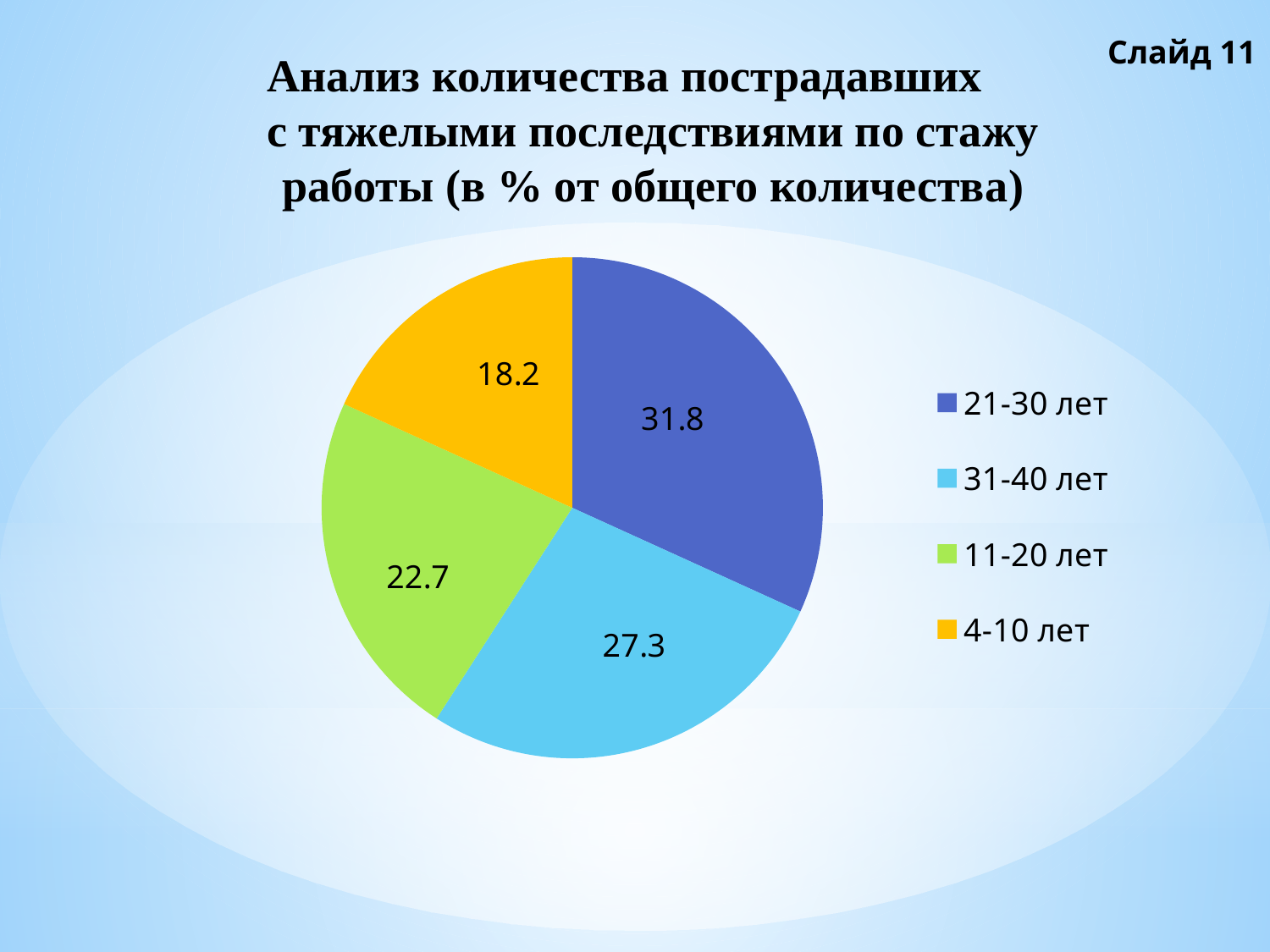
What is the value for the 11-20 лет slice? 22.7 What is the value for the 4-10 лет slice? 18.2 Which legend entry is listed last? 4-10 лет What kind of chart is shown on the slide? pie chart Which is larger, the value for 31-40 лет or the value for 11-20 лет? 31-40 лет What is the value for the 31-40 лет slice? 27.3 What colour is the 11-20 лет slice? green How many slices does the pie chart have? 4 What is the value for the 21-30 лет slice? 31.8 Which category has the largest slice? 21-30 лет What is the difference between the values for 21-30 лет and 4-10 лет? 13.6 Which category has the smallest slice? 4-10 лет